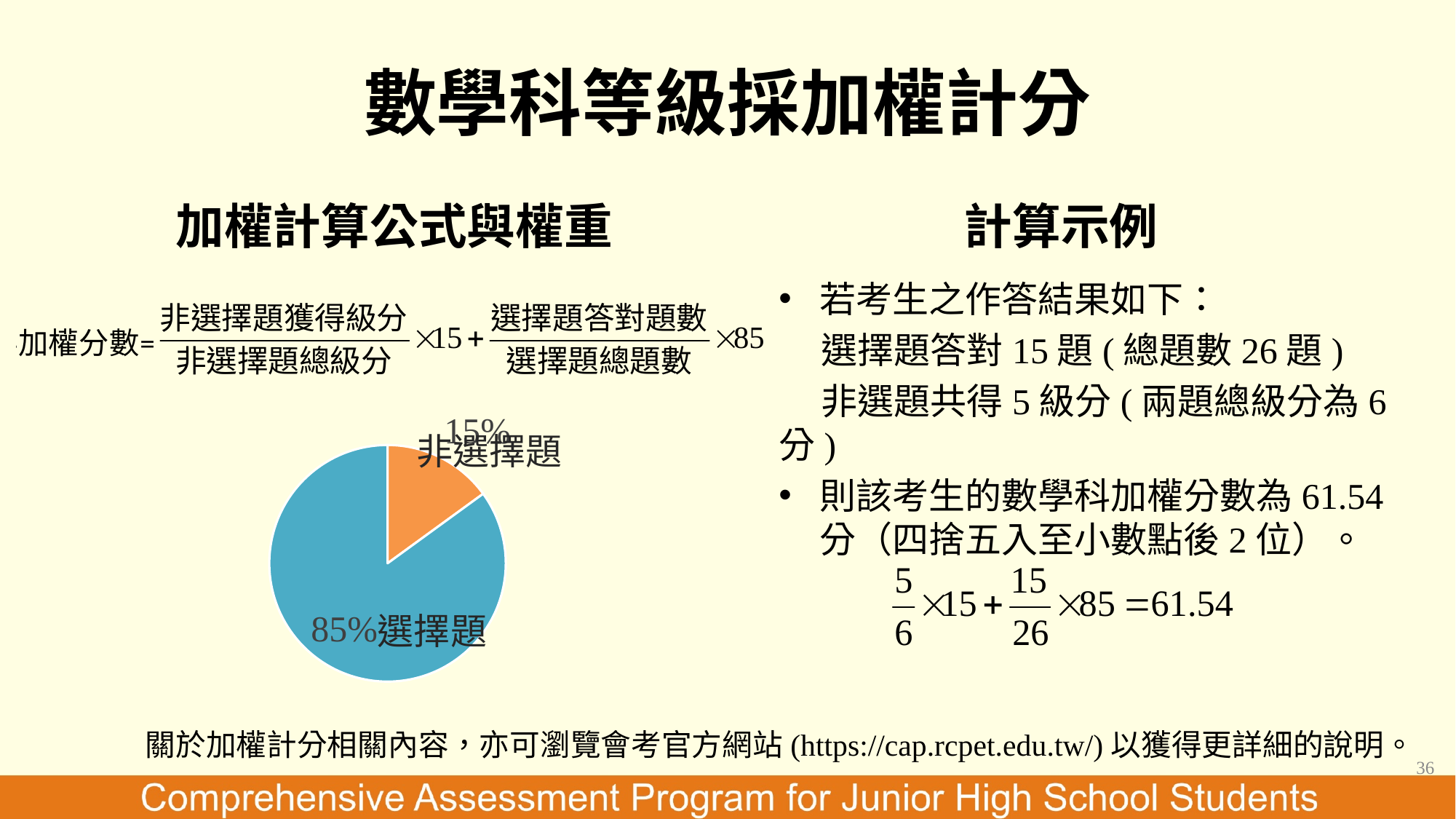
What share of the pie chart does 選擇題 take? 85% Which slice of the pie chart is the smallest? 非選擇題 In the pie chart, which is larger: 選擇題 or 非選擇題? 選擇題 Is the share for 非選擇題 in the pie chart greater or less than 50%? less How many slices does the pie chart have? 2 Which slice of the pie chart is the largest? 選擇題 What is the difference in percentage points between the 選擇題 slice and the 非選擇題 slice? 70 What colour is the 非選擇題 slice in the pie chart? orange What share of the pie chart does 非選擇題 take? 15% What kind of chart is shown on the slide? pie chart What colour is the 選擇題 slice in the pie chart? blue